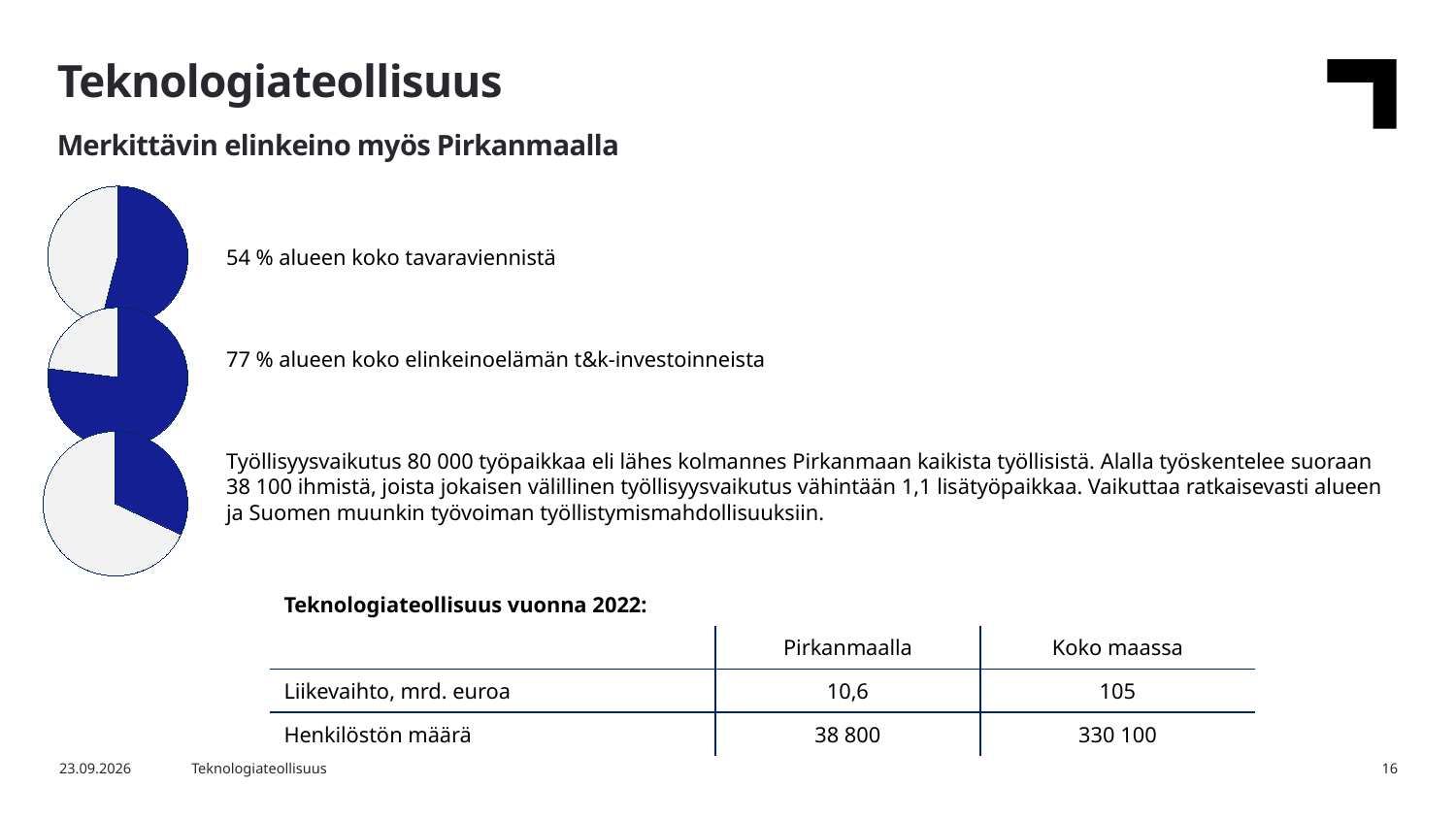
In the bottom pie chart, is the blue slice greater or less than 50% of the pie? less What is the difference in percentage points between the blue shares of the middle and top pie charts? 23 percentage points What kind of charts are shown on the left side of the slide? Pie charts What two colours are used for the slices in the pie charts? Blue and light grey Is the blue slice larger in the top pie chart or in the middle pie chart? The middle pie chart Which of the three pie charts has the largest blue slice? The middle pie chart (77 %) In the top pie chart, what share of the region's total goods exports does the blue slice represent? 54 % How many slices does each pie chart have? 2 Which of the three pie charts has the smallest blue slice? The bottom pie chart In the top pie chart, is the blue slice greater or less than 50% of the pie? greater In the middle pie chart, what share of the region's business R&D investments does the blue slice represent? 77 % How many pie charts are on the slide? 3